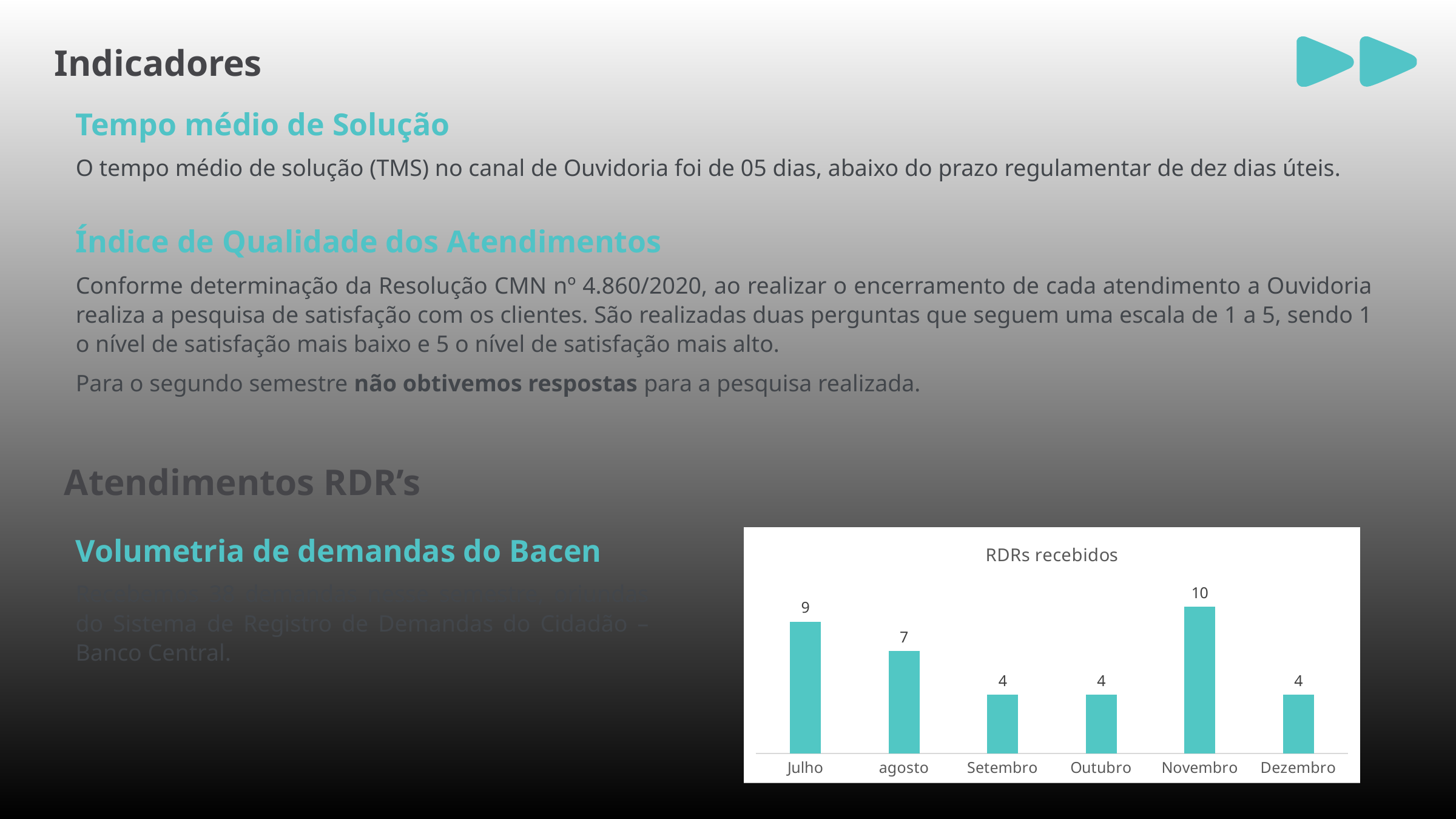
What is the value for agosto in the RDRs recebidos chart? 7 What is the title of the chart on the slide? RDRs recebidos What is the value for Setembro in the RDRs recebidos chart? 4 What is the difference between the values for Novembro and Julho in the RDRs recebidos chart? 1 What is the value for Novembro in the RDRs recebidos chart? 10 Which is larger in the RDRs recebidos chart, the value for Julho or the value for agosto? Julho What kind of chart is the RDRs recebidos chart? bar chart Which month has the highest value in the RDRs recebidos chart? Novembro How many months in the RDRs recebidos chart have a value of 4? 3 How many months are shown in the RDRs recebidos chart? 6 What is the difference between the values for agosto and Outubro in the RDRs recebidos chart? 3 What is the value for Julho in the RDRs recebidos chart? 9